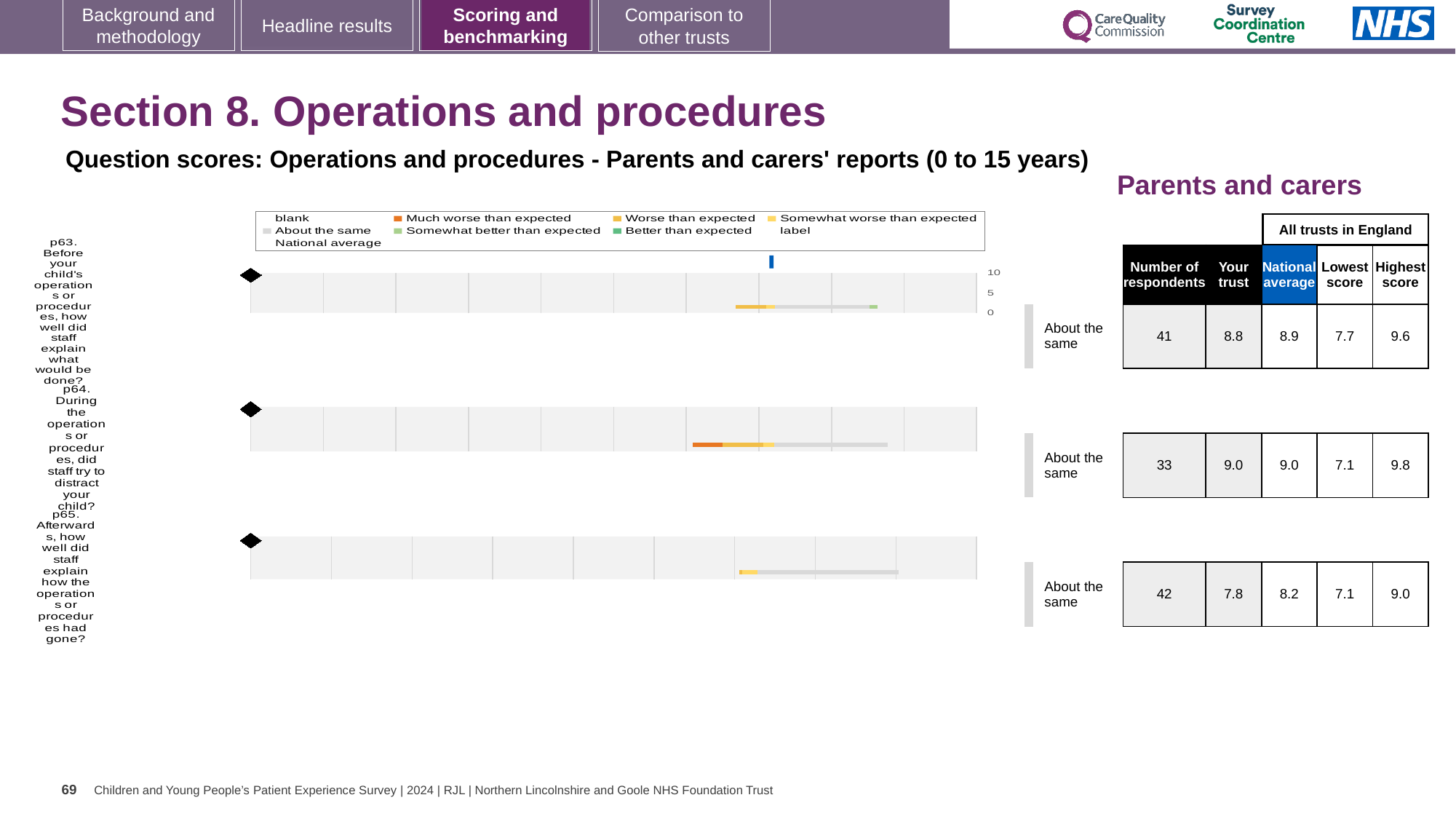
Which question has the lowest 'Your trust' score? p65 What is the 'Your trust' score for question p63 (how well staff explained what would be done before the operation)? 8.8 What is the national average score for question p65 (how well staff explained how the operation had gone)? 8.2 What is the difference between the national average and the 'Your trust' score for question p65? 0.4 What is the lowest score among all trusts in England for question p63? 7.7 What benchmark category is shown for question p63? About the same How many questions are plotted on the slide? 3 How many respondents answered question p64 (did staff try to distract your child)? 33 Which question has the highest 'Your trust' score? p64 What kind of chart is used to show the question scores? Bar chart Which has the larger 'Your trust' score, question p63 or question p65? p63 What is the highest score among all trusts in England for question p64? 9.8